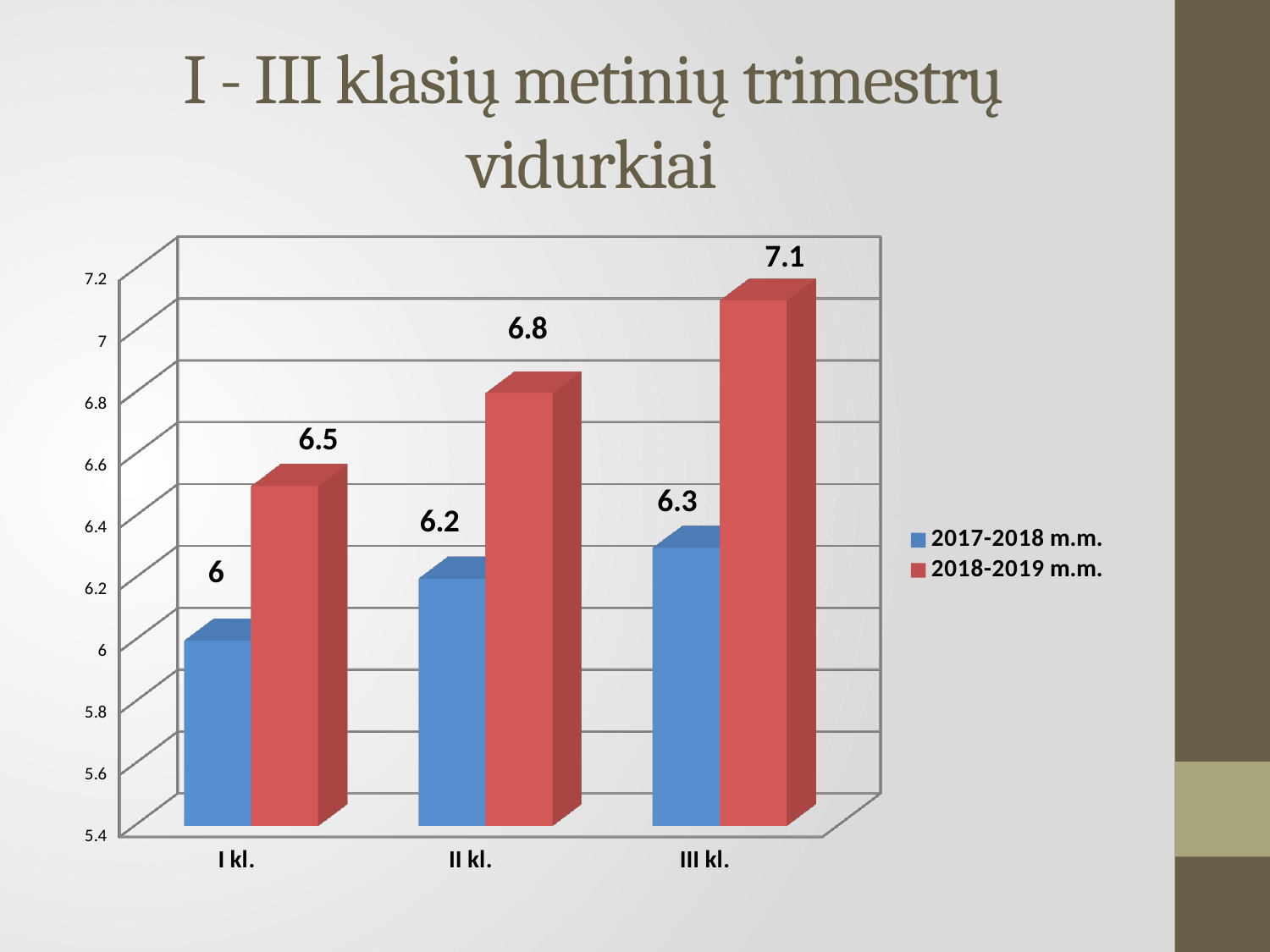
Which is larger for II kl.: the 2017-2018 m.m. value or the 2018-2019 m.m. value? 2018-2019 m.m. What is the difference between the 2018-2019 m.m. and 2017-2018 m.m. values for III kl.? 0.8 What kind of chart is shown on the slide? bar chart What is the value for III kl. in the 2018-2019 m.m. series? 7.1 Which category has the lowest value in the 2017-2018 m.m. series? I kl. How many series does the legend list? 2 What is the value for II kl. in the 2017-2018 m.m. series? 6.2 How many categories are shown on the x axis? 3 Which category has the highest value in the 2018-2019 m.m. series? III kl. What is the value for I kl. in the 2017-2018 m.m. series? 6 Is the value for I kl. in the 2018-2019 m.m. series greater or less than 6.4? greater Do the values in the 2017-2018 m.m. series rise or fall from I kl. to III kl.? rise